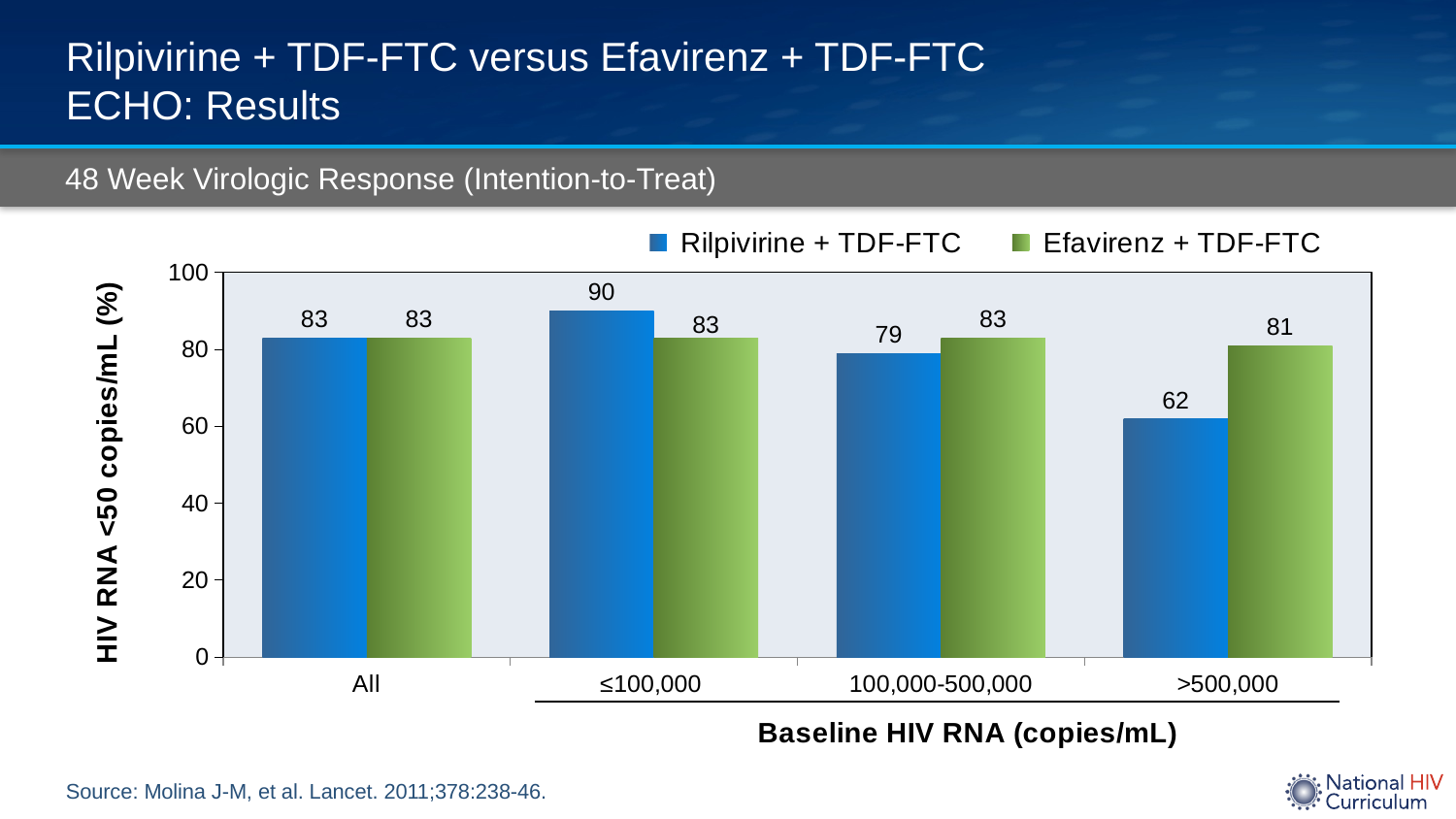
What is the value for Rilpivirine + TDF-FTC in the All category? 83 How many baseline HIV RNA categories are shown on the x axis? 4 What is the value for Rilpivirine + TDF-FTC in the ≤100,000 category? 90 What is the label of the y axis? HIV RNA <50 copies/mL (%) In the 100,000-500,000 category, which series has the larger value? Efavirenz + TDF-FTC How many series does the legend list? 2 What is the difference between Efavirenz + TDF-FTC and Rilpivirine + TDF-FTC in the >500,000 category? 19 Which category has the highest value for Rilpivirine + TDF-FTC? ≤100,000 What is the value for Efavirenz + TDF-FTC in the 100,000-500,000 category? 83 What is the value for Efavirenz + TDF-FTC in the >500,000 category? 81 What kind of chart is shown on the slide? Bar chart Which category has the lowest value for Rilpivirine + TDF-FTC? >500,000